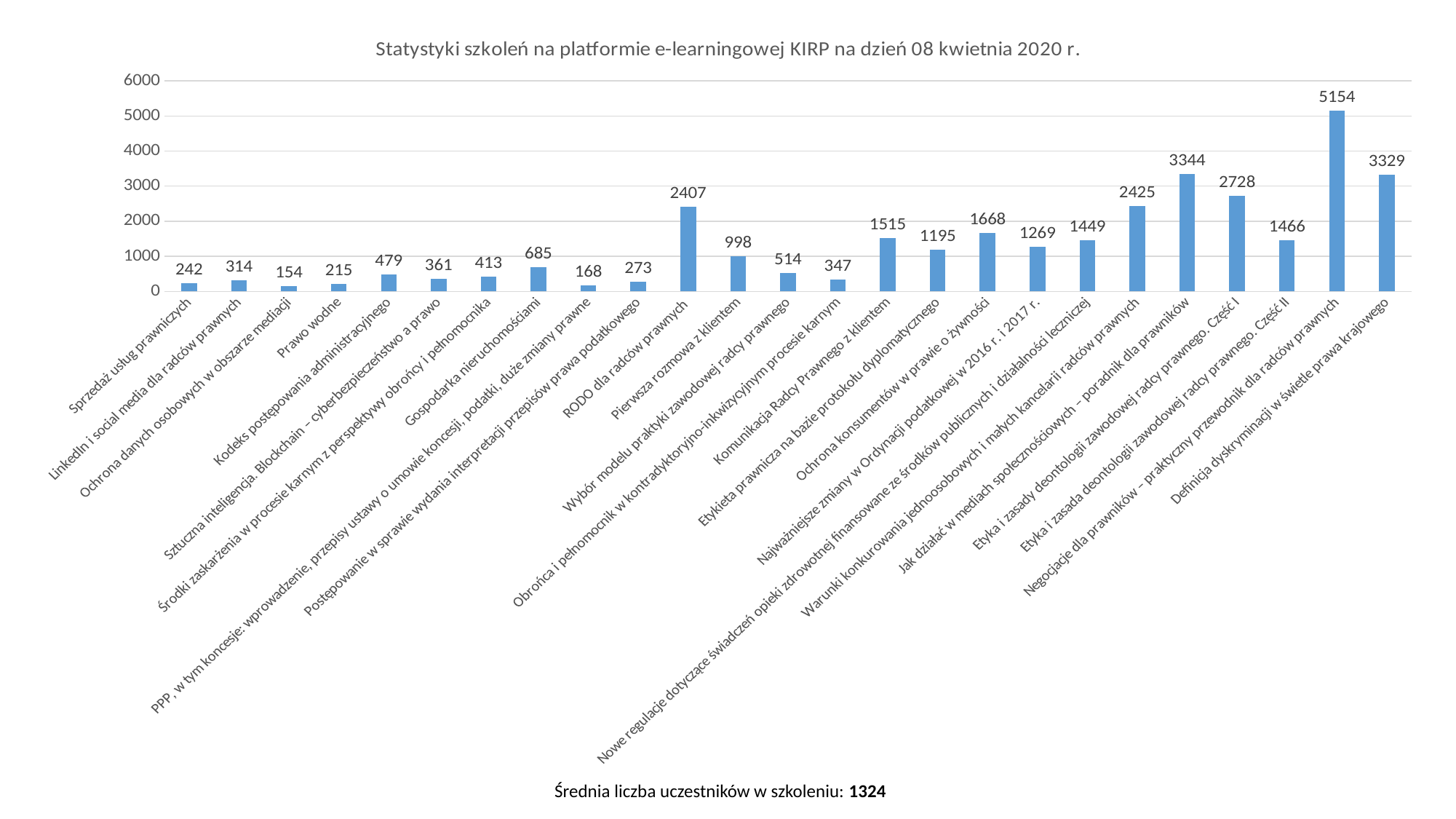
What is the value for "Gospodarka nieruchomościami"? 685 What is the difference between the values for "Jak działać w mediach społecznościowych – poradnik dla prawników" and "Definicja dyskryminacji w świetle prawa krajowego"? 15 Which is larger: the value for "Pierwsza rozmowa z klientem" or the value for "Komunikacja Radcy Prawnego z klientem"? Komunikacja Radcy Prawnego z klientem What average number of participants per training is stated below the chart? 1324 What kind of chart is shown on the slide? bar chart Which category has the highest value? Negocjacje dla prawników – praktyczny przewodnik dla radców prawnych What is the title of the chart? Statystyki szkoleń na platformie e-learningowej KIRP na dzień 08 kwietnia 2020 r. Which category has the lowest value? Ochrona danych osobowych w obszarze mediacji Is the value for "Etyka i zasady deontologii zawodowej radcy prawnego. Część I" greater or less than 3000? less What is the value for "Prawo wodne"? 215 How many categories are shown on the chart? 25 What is the value for "RODO dla radców prawnych"? 2407